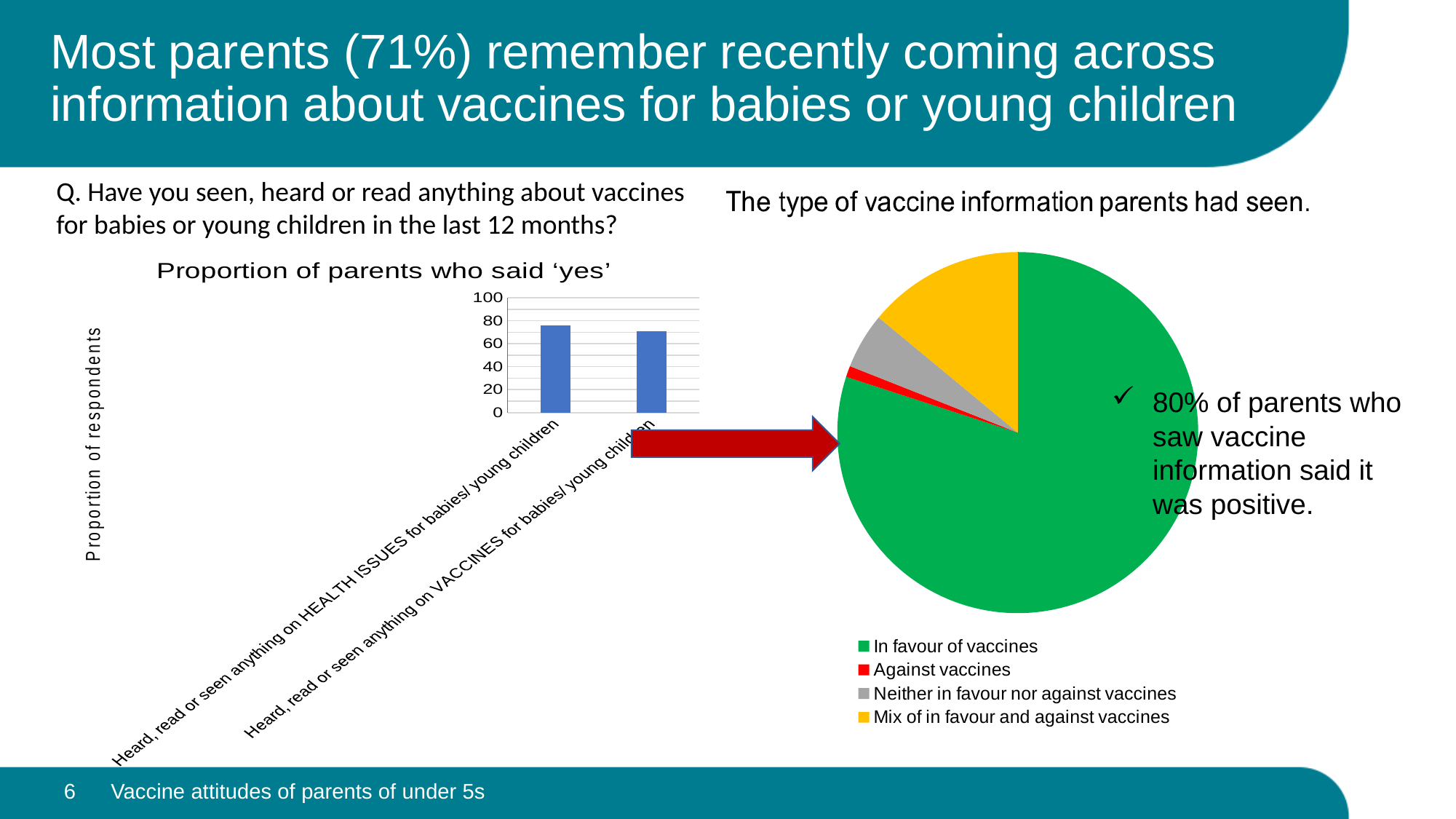
In the pie chart 'The type of vaccine information parents had seen.', which category has the smallest slice? Against vaccines In the 'Proportion of parents who said ‘yes’' bar chart, which bar is taller: HEALTH ISSUES or VACCINES? HEALTH ISSUES In the pie chart 'The type of vaccine information parents had seen.', how many entries does the legend list? 4 In the 'Proportion of parents who said ‘yes’' bar chart, how many bars are plotted? 2 What is the y-axis label of the 'Proportion of parents who said ‘yes’' bar chart? Proportion of respondents In the pie chart 'The type of vaccine information parents had seen.', which slice is larger: 'Neither in favour nor against vaccines' or 'Mix of in favour and against vaccines'? Mix of in favour and against vaccines In the 'Proportion of parents who said ‘yes’' bar chart, is the value for 'Heard, read or seen anything on VACCINES for babies/ young children' greater or less than 60? greater In the pie chart 'The type of vaccine information parents had seen.', which category has the largest slice? In favour of vaccines What kind of chart is 'The type of vaccine information parents had seen.' on the right? pie chart In the pie chart 'The type of vaccine information parents had seen.', what colour is the 'In favour of vaccines' slice? green What kind of chart is the 'Proportion of parents who said ‘yes’' chart on the left? bar chart In the 'Proportion of parents who said ‘yes’' bar chart, is the value for 'Heard, read or seen anything on HEALTH ISSUES for babies/ young children' greater or less than 80? less